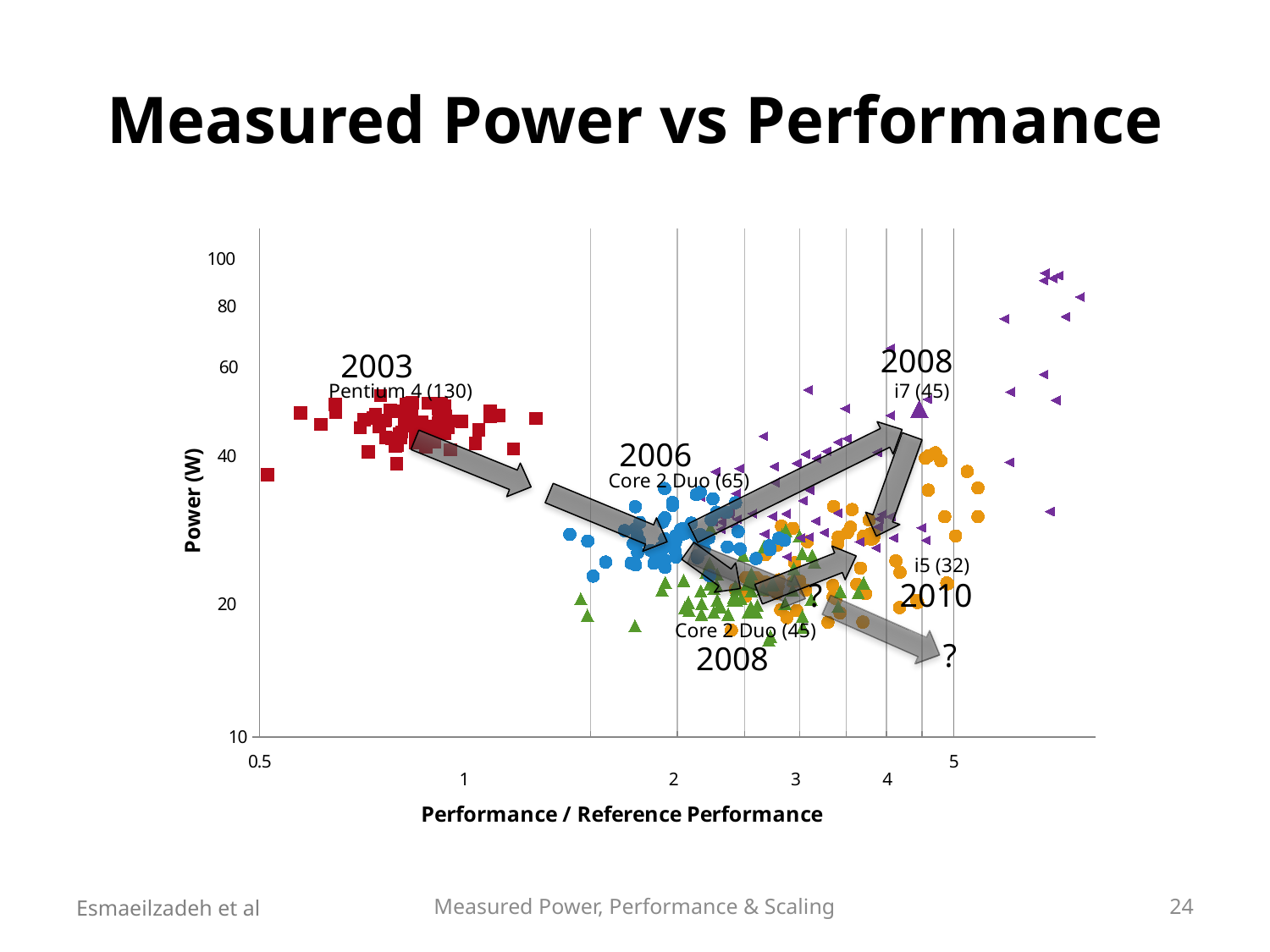
Which processor group is labeled with the year 2010? i5 (32) Is the power of the Core 2 Duo (45) cluster greater or less than 40 W? less Is the power of the Pentium 4 (130) cluster greater or less than 20 W? greater Which group has higher performance: Pentium 4 (130) or i7 (45)? i7 (45) What is the title of the chart? Measured Power vs Performance Is the performance ratio of the Pentium 4 (130) cluster greater or less than 2? less Which processor group is labeled with the year 2003? Pentium 4 (130) What is the label of the vertical axis? Power (W) What kind of chart is shown on the slide? scatter chart How many labeled processor groups are shown in the chart? 5 Which group has higher power: Pentium 4 (130) or Core 2 Duo (45)? Pentium 4 (130) What is the highest value shown on the Power (W) axis? 100